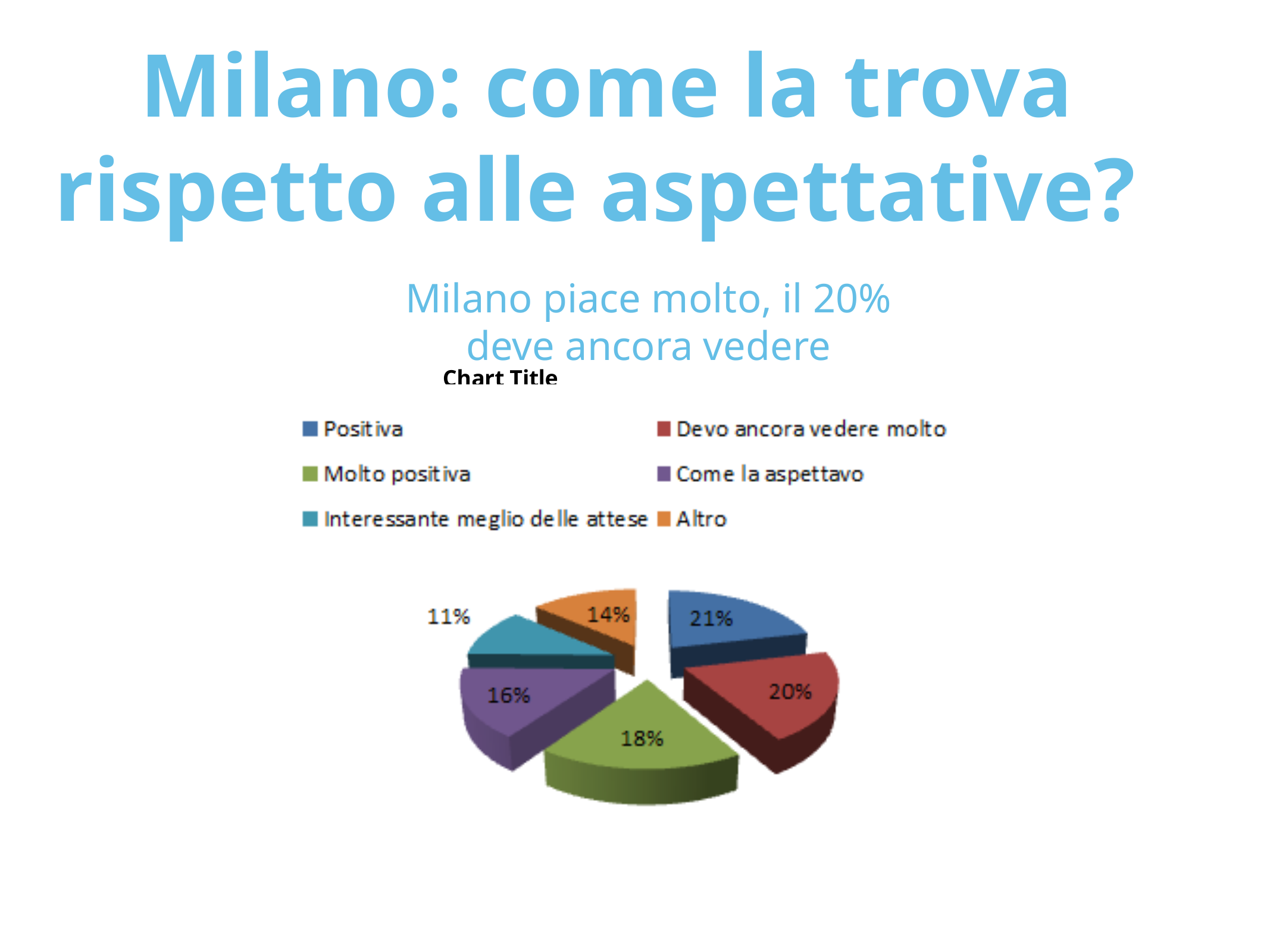
Which category has the smallest slice of the pie? Interessante meglio delle attese What percentage is shown for 'Devo ancora vedere molto'? 20% Which is larger, the 'Molto positiva' slice or the 'Altro' slice? Molto positiva What percentage is shown for 'Molto positiva'? 18% What percentage is shown for 'Altro'? 14% What percentage is shown for 'Interessante meglio delle attese'? 11% What is the difference in percentage points between 'Positiva' and 'Interessante meglio delle attese'? 10 What kind of chart is shown on the slide? Pie chart What percentage is shown for 'Come la aspettavo'? 16% How many categories does the legend list? 6 What percentage of the pie is labelled for the 'Positiva' slice? 21% Which category has the largest slice of the pie? Positiva